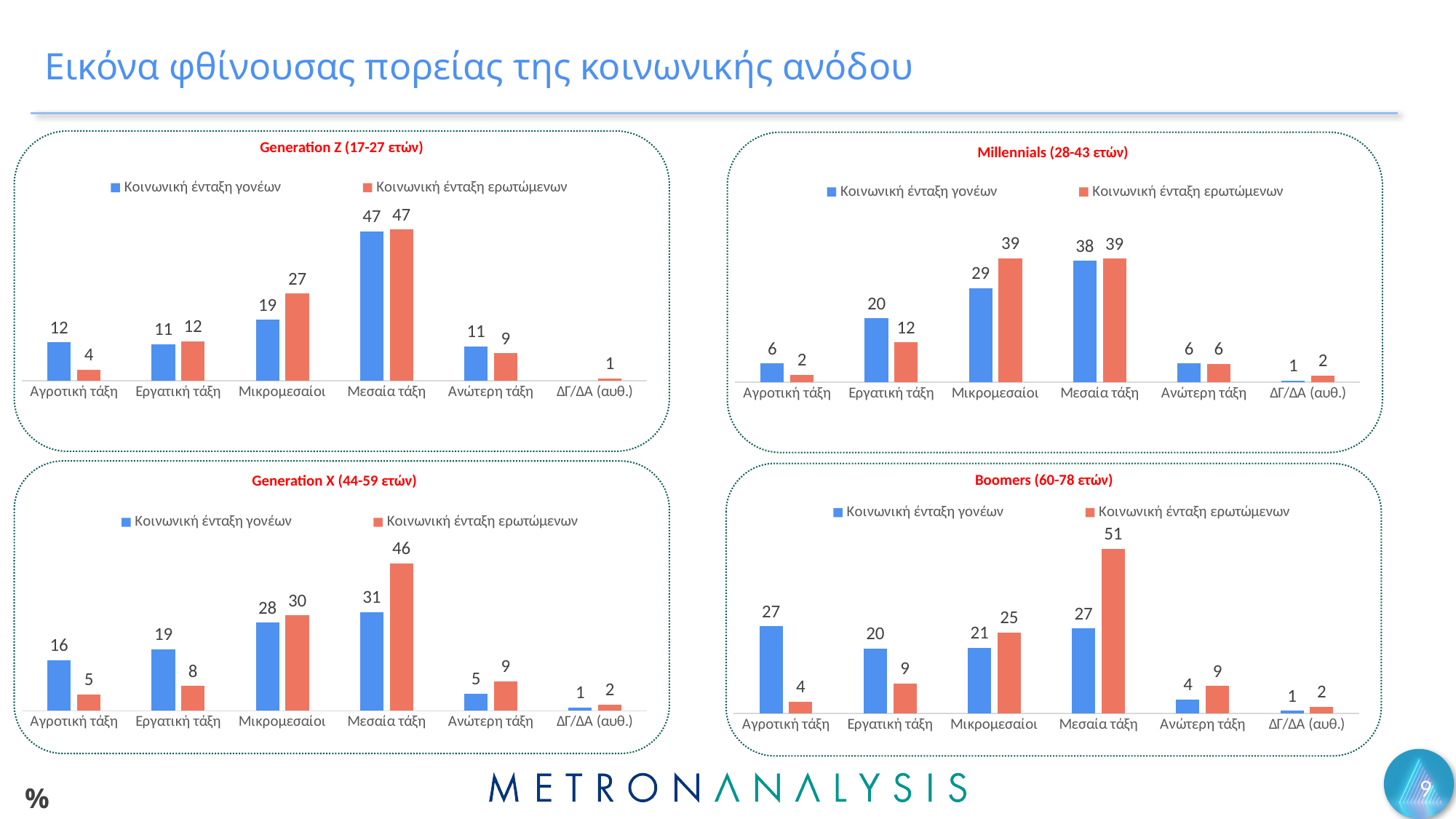
In the Generation X (44-59 ετών) chart, what is the difference between Κοινωνική ένταξη ερωτώμενων and Κοινωνική ένταξη γονέων for Μεσαία τάξη? 15 In the Boomers (60-78 ετών) chart, what is the difference between Κοινωνική ένταξη ερωτώμενων and Κοινωνική ένταξη γονέων for Μεσαία τάξη? 24 How many categories are shown on the x axis of the Generation X (44-59 ετών) chart? 6 What type of chart is the Generation Z (17-27 ετών) chart? Bar chart How many series does the legend list in the Millennials (28-43 ετών) chart? 2 In the Millennials (28-43 ετών) chart, what is the value of Κοινωνική ένταξη γονέων for Μεσαία τάξη? 38 In the Millennials (28-43 ετών) chart, what is the value of Κοινωνική ένταξη ερωτώμενων for Εργατική τάξη? 12 In the Generation Z (17-27 ετών) chart, what is the value of Κοινωνική ένταξη ερωτώμενων for Μικρομεσαίοι? 27 In the Boomers (60-78 ετών) chart, which category has the highest value for Κοινωνική ένταξη ερωτώμενων? Μεσαία τάξη In the Boomers (60-78 ετών) chart, which is larger for Αγροτική τάξη: Κοινωνική ένταξη γονέων or Κοινωνική ένταξη ερωτώμενων? Κοινωνική ένταξη γονέων In the Generation X (44-59 ετών) chart, which category has the lowest value for Κοινωνική ένταξη γονέων? ΔΓ/ΔΑ (αυθ.) Which colour represents Κοινωνική ένταξη γονέων in the Generation Z (17-27 ετών) chart? Blue